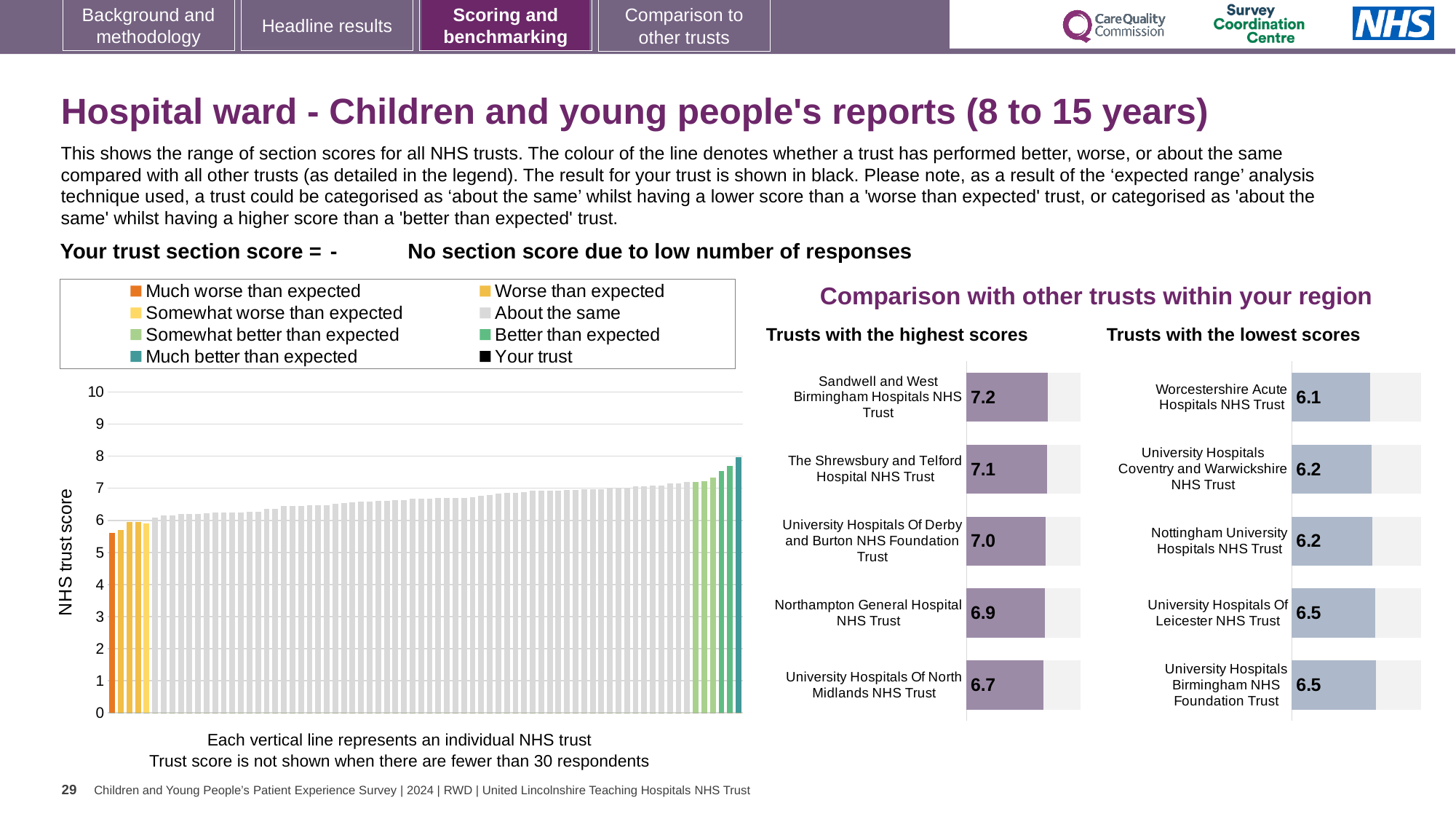
In the 'Trusts with the highest scores' chart, what is the difference between the scores of Sandwell and West Birmingham Hospitals NHS Trust and University Hospitals Of North Midlands NHS Trust? 0.5 In the 'Trusts with the lowest scores' chart, what is the score for Nottingham University Hospitals NHS Trust? 6.2 What kind of chart is the large 'NHS trust score' chart on the left of the slide? Bar chart How many entries does the legend above the 'NHS trust score' chart list? 8 In the 'Trusts with the lowest scores' chart, what is the score for Worcestershire Acute Hospitals NHS Trust? 6.1 Which has the higher score: Northampton General Hospital NHS Trust in the highest scores chart, or University Hospitals Of Leicester NHS Trust in the lowest scores chart? Northampton General Hospital NHS Trust How many trusts are shown in the 'Trusts with the highest scores' chart? 5 In the 'Trusts with the highest scores' chart, which trust has the highest score? Sandwell and West Birmingham Hospitals NHS Trust In the large 'NHS trust score' chart on the left, is the value of the leftmost (orange) bar greater or less than 5? greater In the 'Trusts with the lowest scores' chart, which trust has the lowest score? Worcestershire Acute Hospitals NHS Trust In the 'Trusts with the highest scores' chart, what is the score for Sandwell and West Birmingham Hospitals NHS Trust? 7.2 In the large 'NHS trust score' chart on the left, do the bar values rise or fall from left to right? Rise